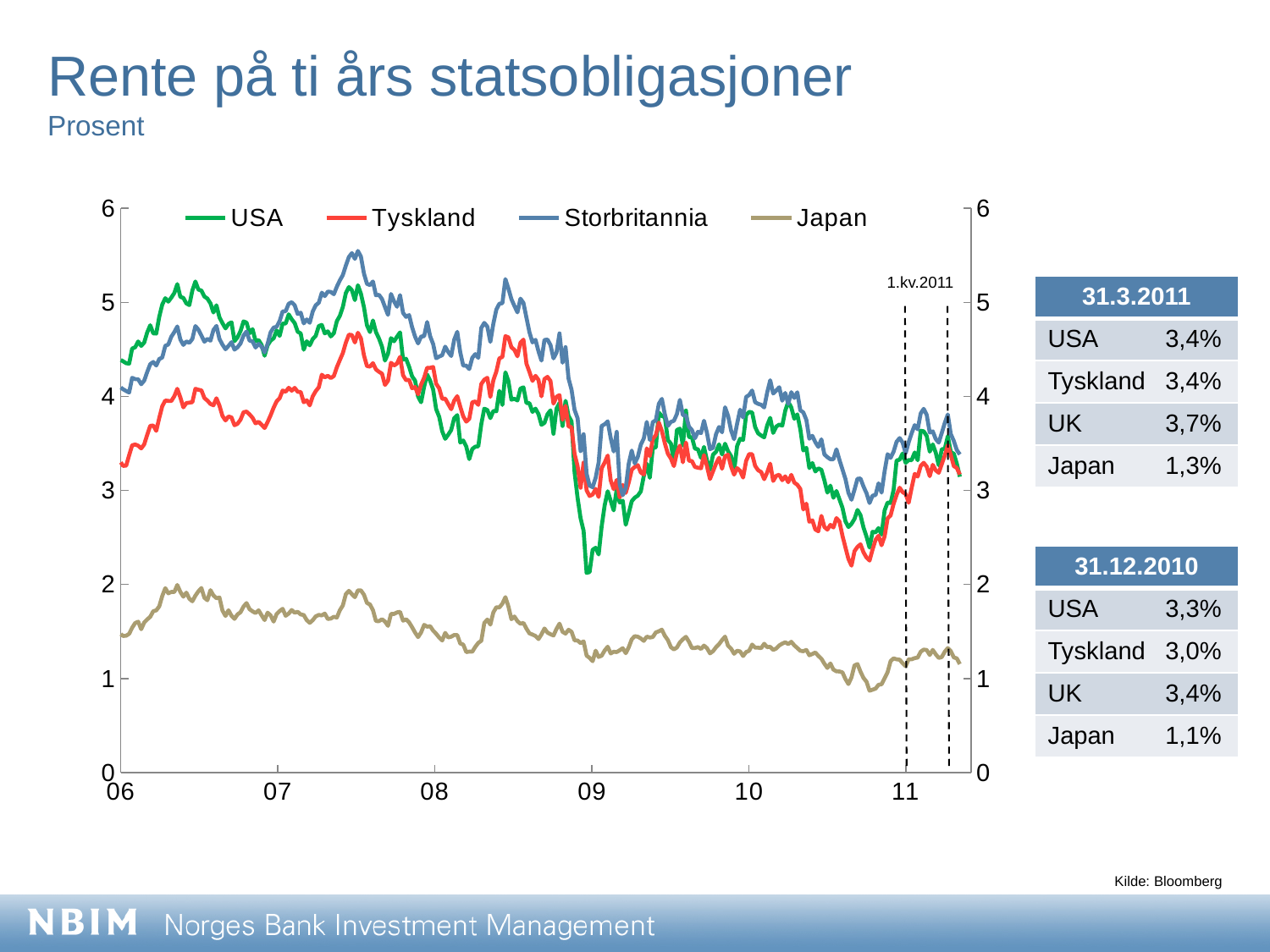
Is the lowest point of the USA line around the start of 2009 greater or less than 3? less According to the table, what was the USA ten-year yield on 31.3.2011? 3,4% How many series does the chart legend list? 4 Does the Japan line generally rise or fall from 2006 to 2011? fall What type of chart is shown on the slide? Line chart By how much did Tyskland's yield change between 31.12.2010 (3,0%) and 31.3.2011 (3,4%)? 0,4% According to the table, what was Japan's ten-year yield on 31.12.2010? 1,1% On 31.3.2011, which was higher: the UK yield or the USA yield? UK Is the Storbritannia line at its 2007 peak greater or less than 5? greater Which series is drawn in red on the chart? Tyskland Which country had the lowest ten-year yield on 31.3.2011? Japan Which country had the highest ten-year yield on 31.12.2010? UK